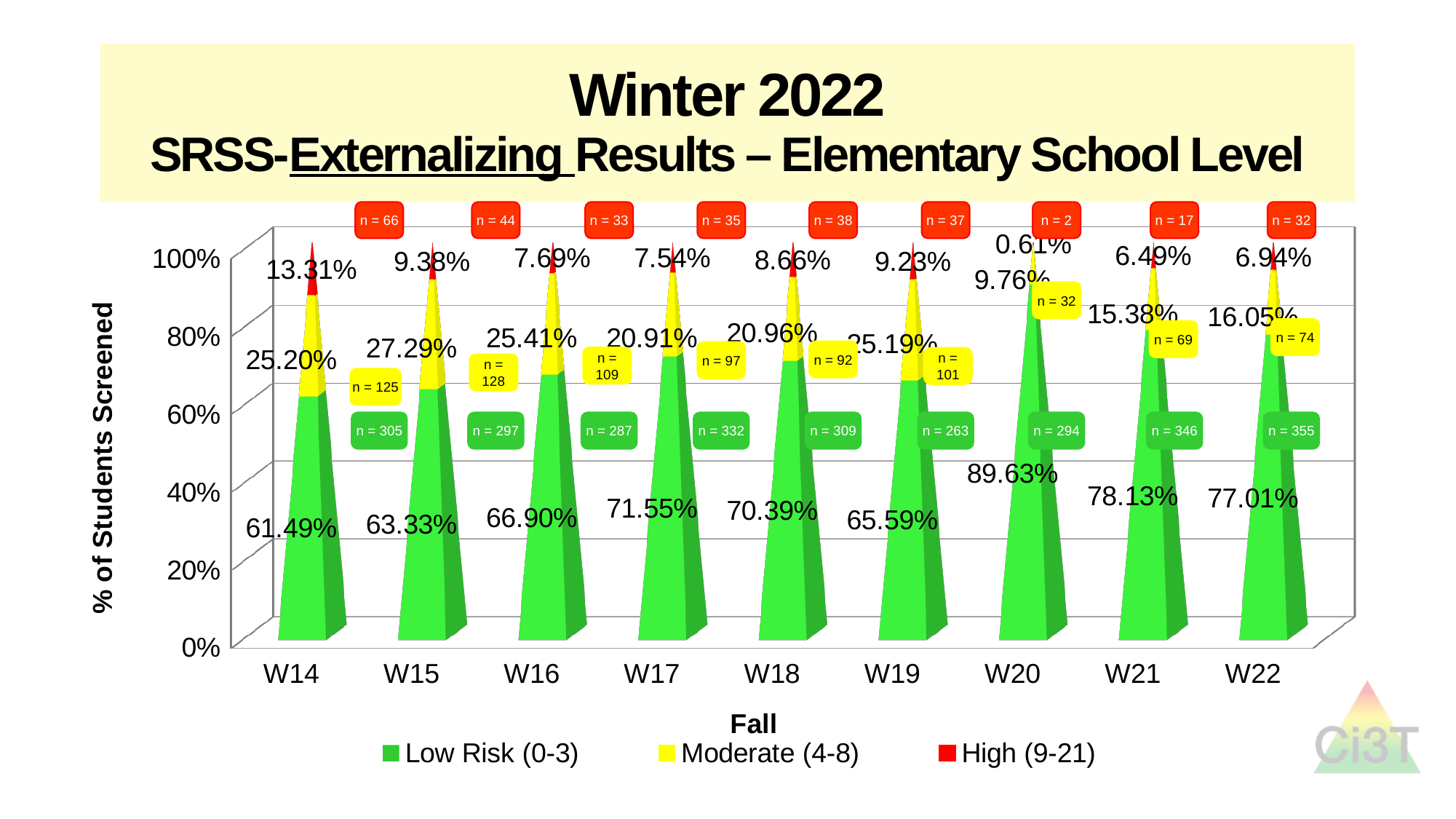
How many series does the legend list? 3 What is the High (9-21) percentage for W14? 13.31% How many schools are shown on the x axis? 9 Which school has the lowest High (9-21) percentage? W20 What is the Low Risk (0-3) percentage for W17? 71.55% Which school has the highest Low Risk (0-3) percentage? W20 What is the difference between the Low Risk (0-3) percentages for W22 and W14? 15.52% What is the x-axis title of the chart? Fall Which has a larger Moderate (4-8) percentage, W15 or W18? W15 What is the n value shown for the High (9-21) group at W20? n = 2 What is the Moderate (4-8) percentage for W21? 15.38% What kind of chart is shown on the slide? Stacked bar chart